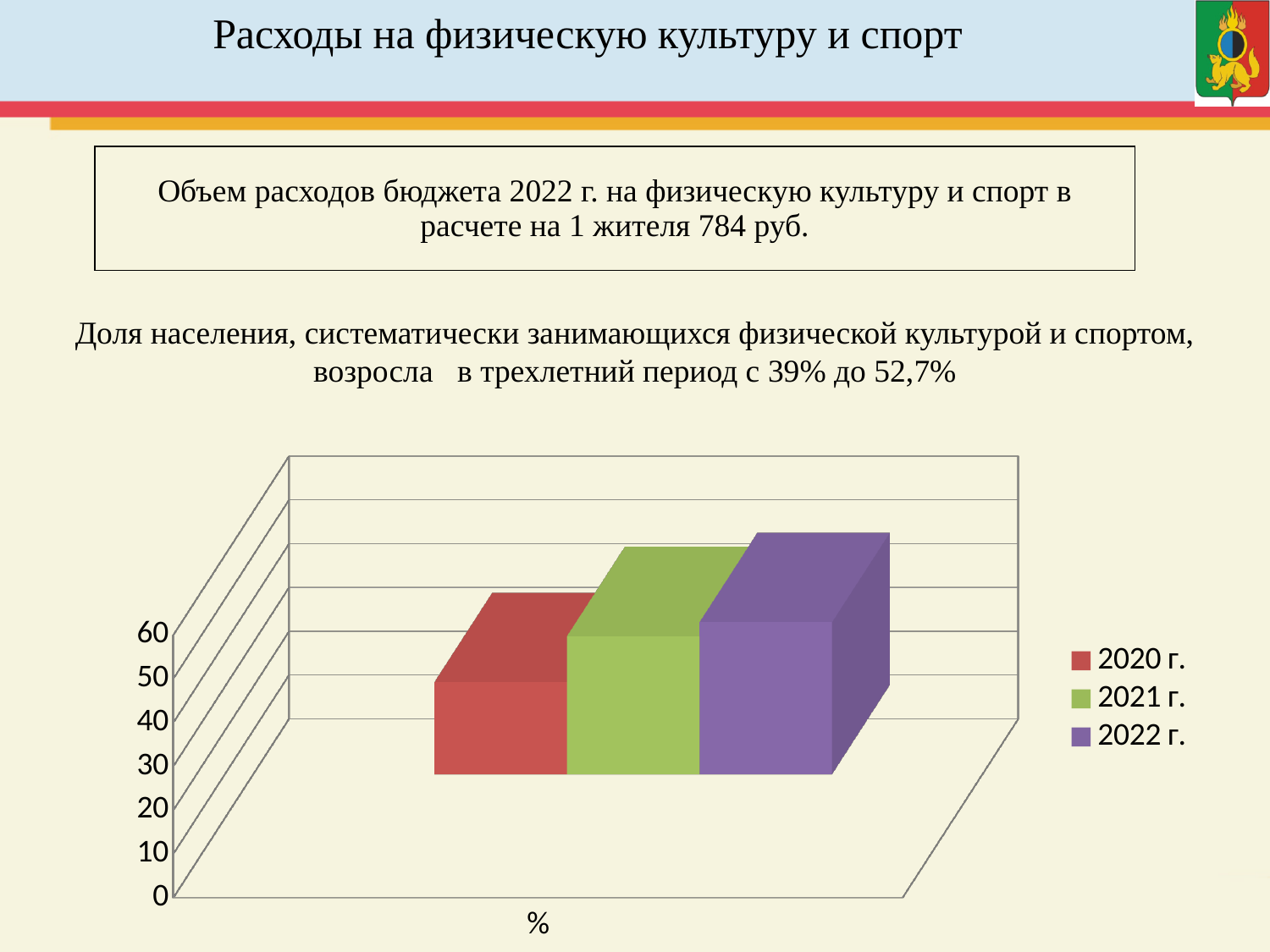
Which series is shown in red in the legend? 2020 г. Which is larger, the bar for 2021 г. or the bar for 2020 г.? 2021 г. Which year has the highest bar? 2022 г. Which series is shown in purple in the legend? 2022 г. How many bars are plotted in the chart? 3 Is the value for 2022 г. greater or less than 30? greater How many series does the legend list? 3 What kind of chart is shown on the slide? bar chart Is the value for 2020 г. greater or less than 60? less Which year has the lowest bar? 2020 г. Do the bars rise or fall from 2020 г. to 2022 г.? rise Which is larger, the bar for 2022 г. or the bar for 2021 г.? 2022 г.